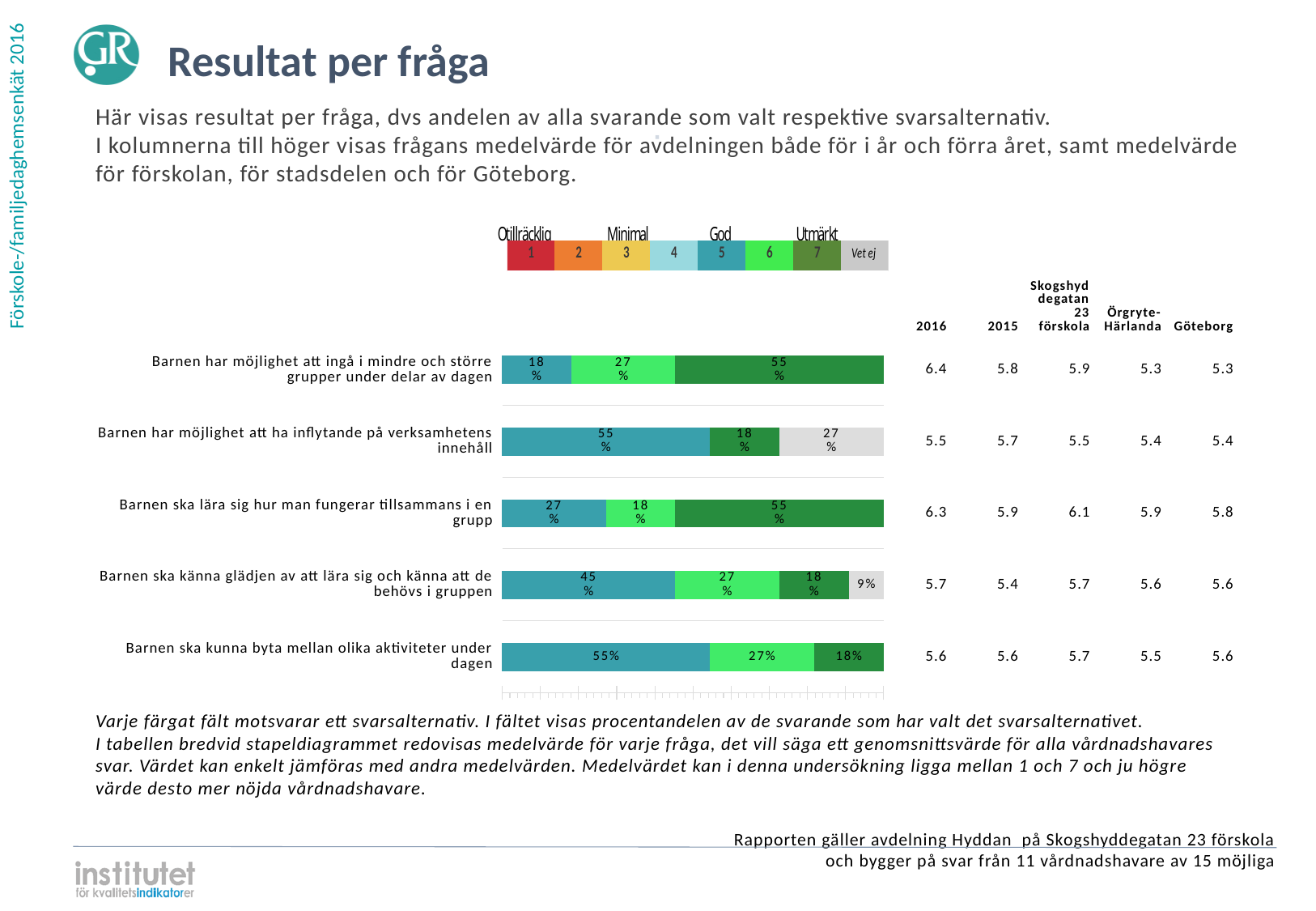
What is the 2016 mean value shown for "Barnen har möjlighet att ingå i mindre och större grupper under delar av dagen"? 6.4 Which question has the largest "Vet ej" share? Barnen har möjlighet att ha inflytande på verksamhetens innehåll For "Barnen ska kunna byta mellan olika aktiviteter under dagen", what is the difference in percentage points between the share choosing 5 and the share choosing 7? 37 How many answer options does the legend above the chart list, including "Vet ej"? 8 What percentage chose "Vet ej" for "Barnen har möjlighet att ha inflytande på verksamhetens innehåll"? 27% What percentage chose 5 (teal) for "Barnen ska känna glädjen av att lära sig och känna att de behövs i gruppen"? 45% What percentage of respondents chose 7 (dark green) for "Barnen har möjlighet att ingå i mindre och större grupper under delar av dagen"? 55% What percentage chose 6 (light green) for "Barnen ska kunna byta mellan olika aktiviteter under dagen"? 27% How many questions (categories) are plotted in the bar chart? 5 What kind of chart is shown on the slide? Stacked bar chart What is the total of the labelled segments for "Barnen ska lära sig hur man fungerar tillsammans i en grupp"? 100% Which is larger: the share choosing 7 for "Barnen har möjlighet att ingå i mindre och större grupper under delar av dagen" or for "Barnen har möjlighet att ha inflytande på verksamhetens innehåll"? Barnen har möjlighet att ingå i mindre och större grupper under delar av dagen